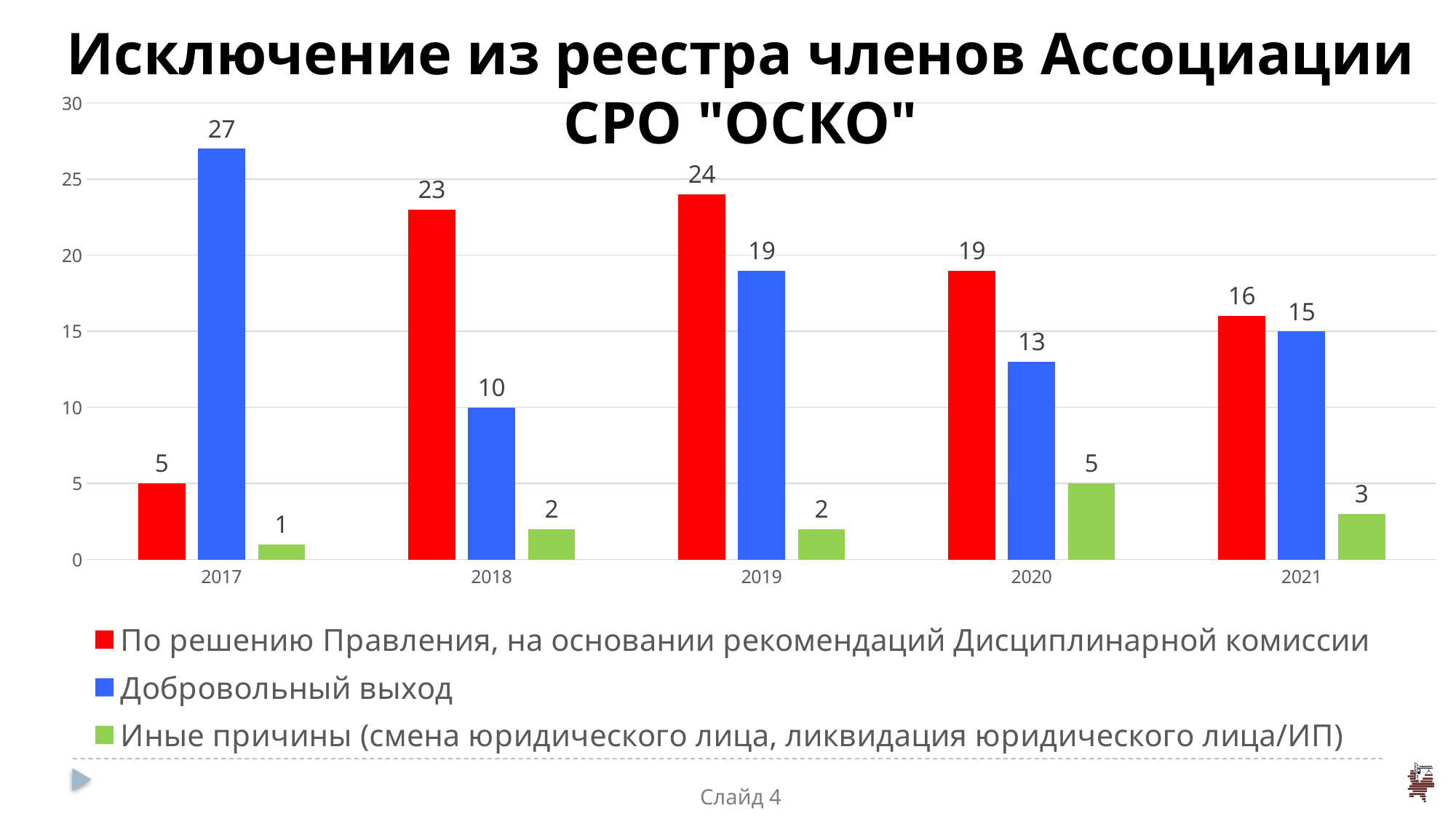
Is the value for "Добровольный выход" in 2020 greater or less than 15? less What is the value for "Добровольный выход" in 2017? 27 What is the value for "Иные причины (смена юридического лица, ликвидация юридического лица/ИП)" in 2020? 5 How many years are shown on the x axis? 5 How many series does the legend list? 3 What is the value for "По решению Правления, на основании рекомендаций Дисциплинарной комиссии" in 2019? 24 What is the difference between the "Добровольный выход" values in 2017 and 2018? 17 In which year is the value for "По решению Правления, на основании рекомендаций Дисциплинарной комиссии" lowest? 2017 Which is larger in 2021: "По решению Правления, на основании рекомендаций Дисциплинарной комиссии" or "Добровольный выход"? По решению Правления, на основании рекомендаций Дисциплинарной комиссии Does the value for "Добровольный выход" rise or fall from 2019 to 2021? fall What kind of chart is shown on the slide? bar chart In which year is the value for "Добровольный выход" highest? 2017